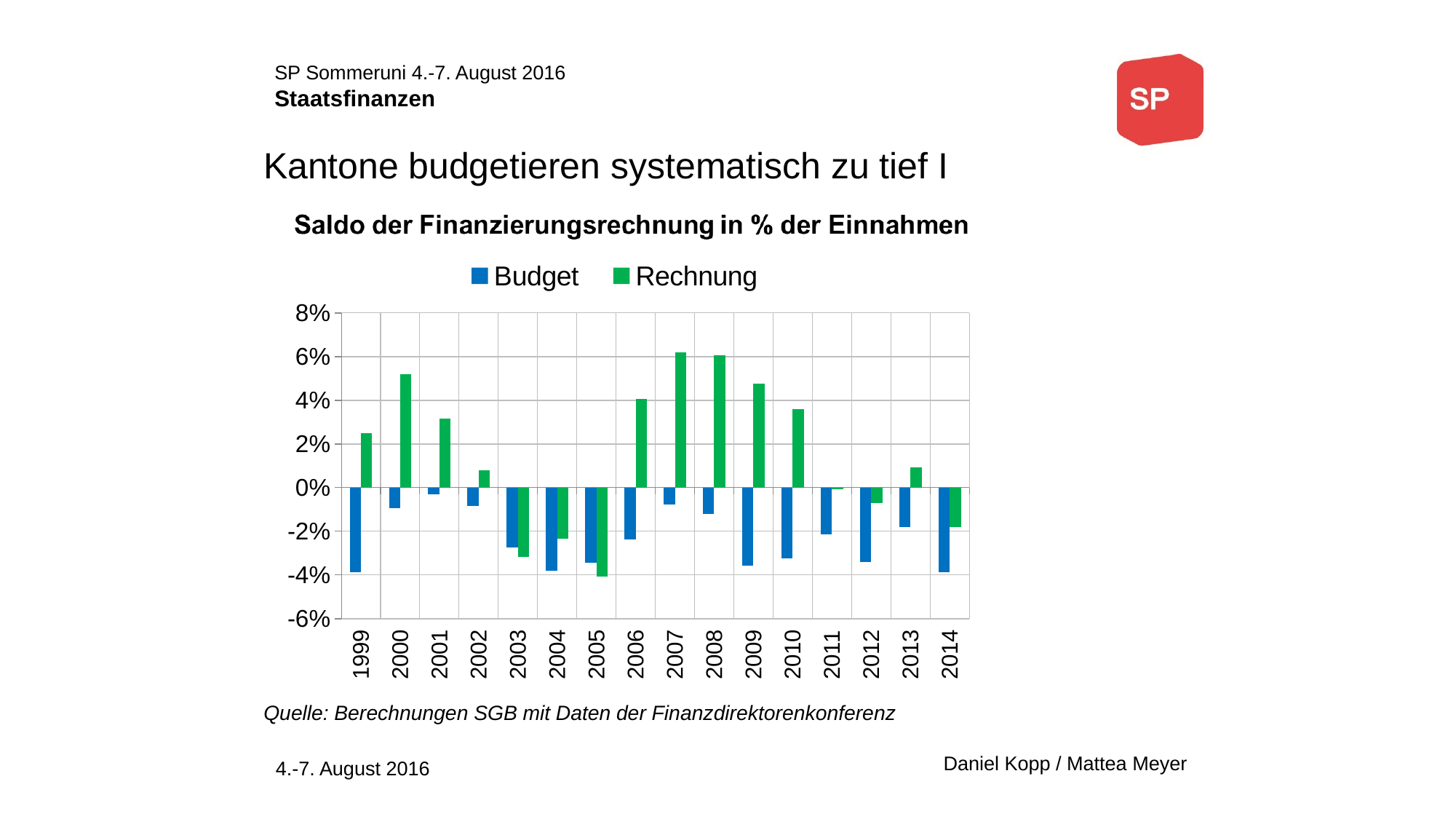
Is the Budget value for 2009 greater or less than -2%? less Which is larger, the Rechnung value for 2000 or for 2001? 2000 How many years are shown on the x axis of the chart? 16 What is the title of the chart? Saldo der Finanzierungsrechnung in % der Einnahmen Which year has the highest Budget value? 2001 How many series does the chart legend list? 2 Is the Budget value for 1999 greater or less than -2%? less Which year has the lowest Rechnung value? 2005 Is the Rechnung value for 2000 greater or less than 4%? greater What kind of chart is shown on the slide? bar chart Which is larger, the Rechnung value for 2006 or for 2010? 2006